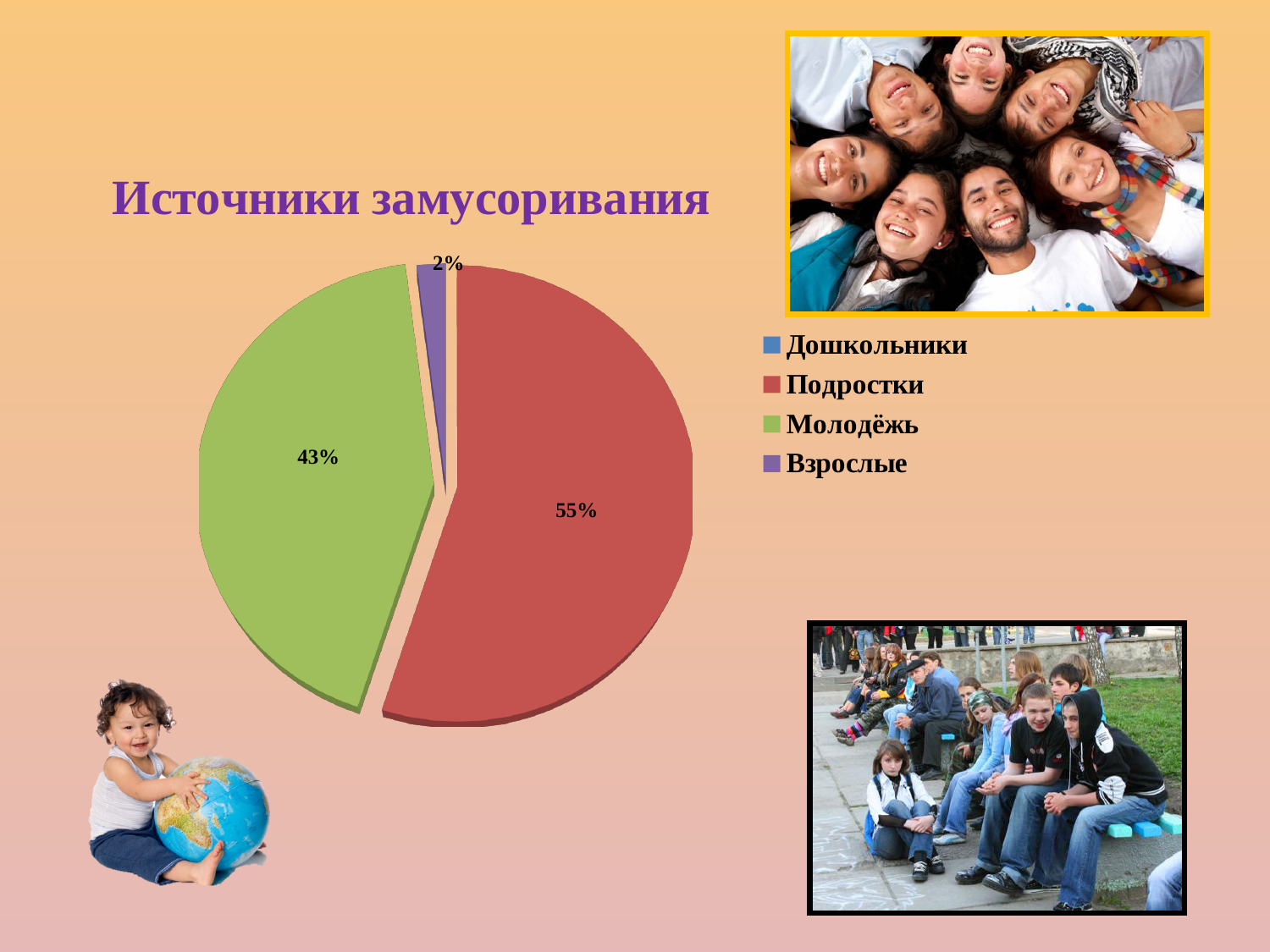
What kind of chart is shown on the slide? pie chart What percentage of the pie is Взрослые? 2% What percentage of the pie is Молодёжь? 43% Is the share for Подростки greater or less than 50%? greater What is the title of the chart? Источники замусоривания What is the difference between the Подростки and Молодёжь shares? 12% Which category has the largest slice of the pie? Подростки What colour represents Молодёжь in the chart? green What is the difference between the Молодёжь and Взрослые shares? 41% How many categories does the legend list? 4 What percentage of the pie is Подростки? 55% Which is larger, the share for Молодёжь or the share for Взрослые? Молодёжь